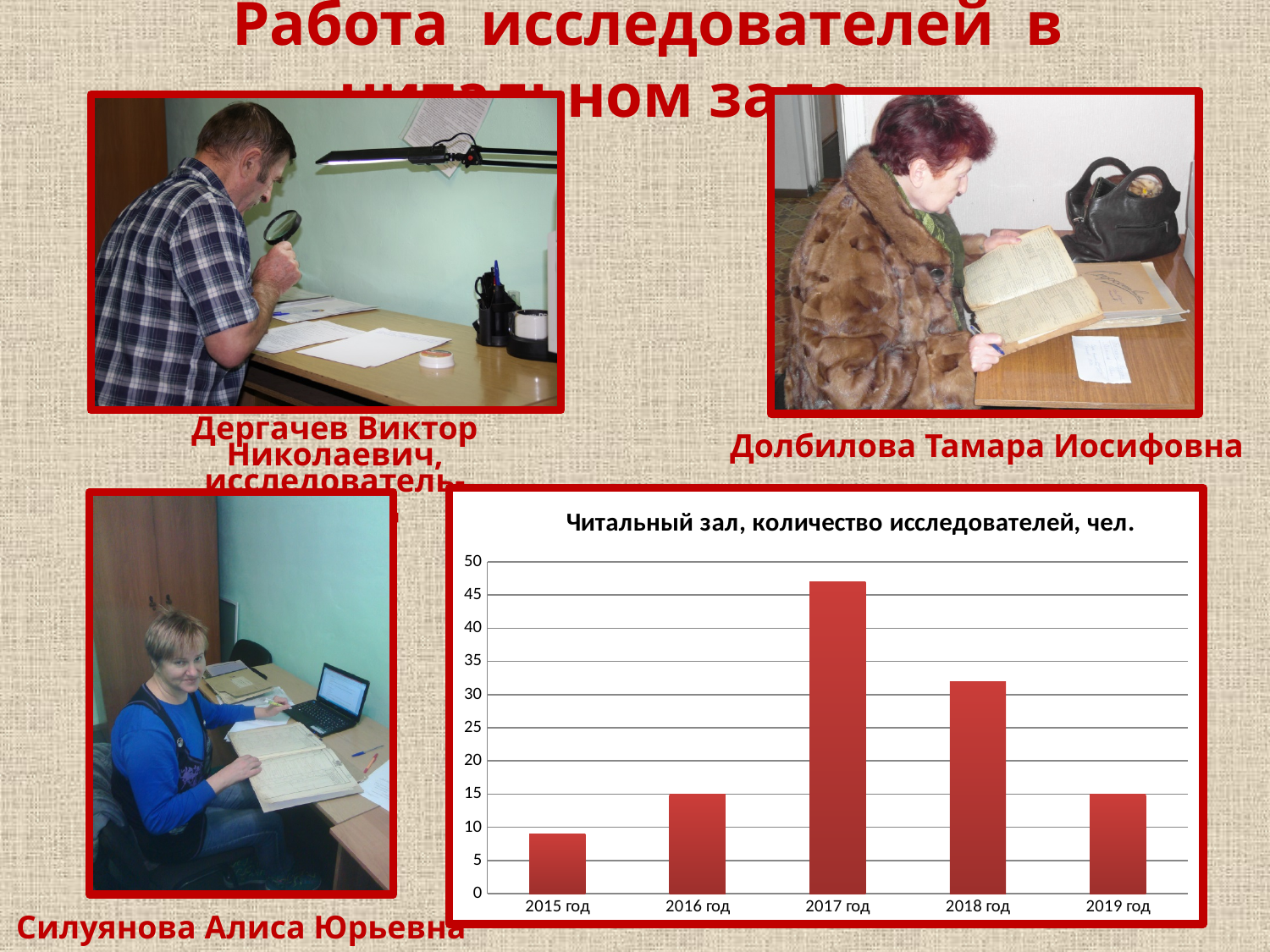
Is the value for 2015 год greater or less than 10? less How many years are shown on the x axis of the chart? 5 Which is larger in the chart, the value for 2017 год or the value for 2018 год? 2017 год What is the value for 2016 год in the chart? 15 What kind of chart is shown on the slide? bar chart Which year has the highest number of researchers in the chart? 2017 год Which year has the lowest number of researchers in the chart? 2015 год Is the value for 2018 год greater or less than 30? greater Is the value for 2017 год greater or less than 45? greater What is the title of the chart? Читальный зал, количество исследователей, чел. Do the values in the chart rise or fall from 2015 год to 2017 год? rise What is the value for 2019 год in the chart? 15